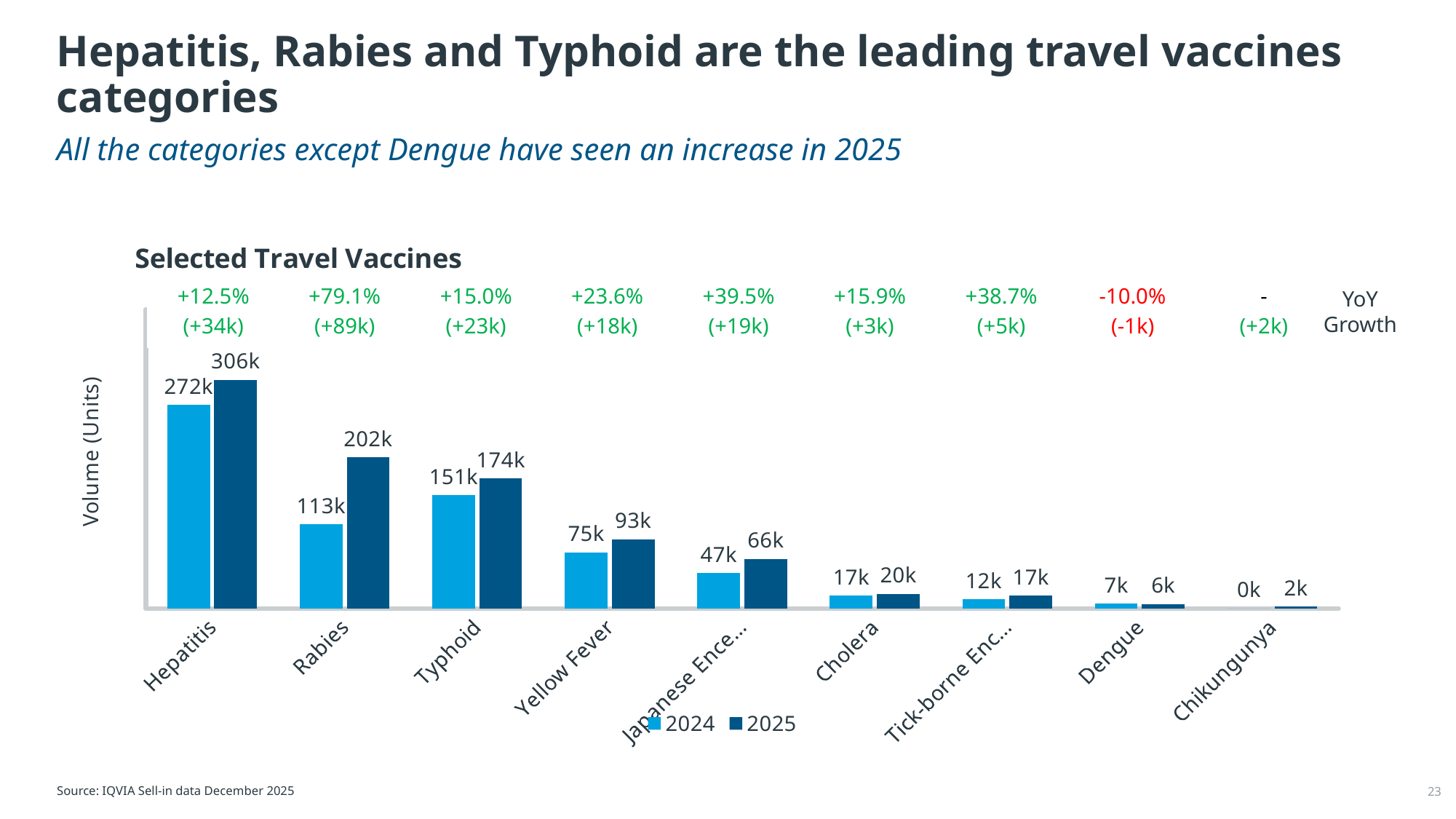
What is the 2025 value for Yellow Fever? 93k What kind of chart is shown? Bar chart How many series does the legend list? 2 What is the difference between the 2025 and 2024 values for Typhoid? 23k Which is larger for Dengue, the 2024 value or the 2025 value? 2024 What is the 2024 value for Rabies? 113k What is the 2025 value for Hepatitis? 306k What is the 2024 value for Cholera? 17k What is the YoY growth percentage shown for Rabies? +79.1% Which category has the highest 2025 value? Hepatitis How many vaccine categories are shown on the x axis? 9 Which category has the lowest 2024 value? Chikungunya